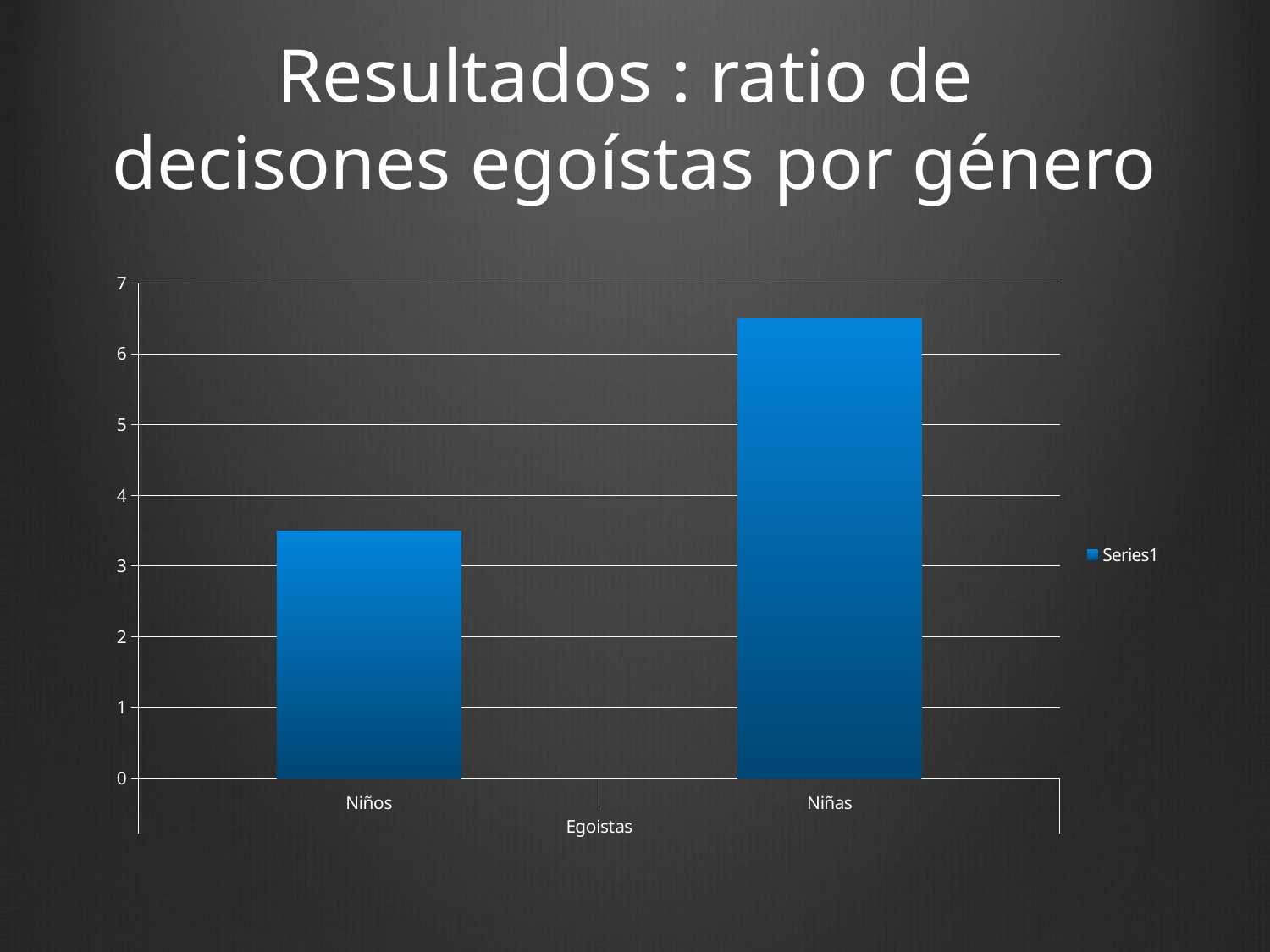
Is the value for Niñas greater or less than 7? less Which category has the highest value? Niñas Is the value for Niños greater or less than 4? less What kind of chart is shown on the slide? bar chart Which category has the lowest value? Niños Is the value for Niños greater or less than 3? greater What is the title of the slide? Resultados : ratio de decisones egoístas por género What label appears below the category names on the x axis? Egoistas Which is larger, the value for Niños or the value for Niñas? Niñas How many series does the legend list? 1 How many categories are shown on the x axis? 2